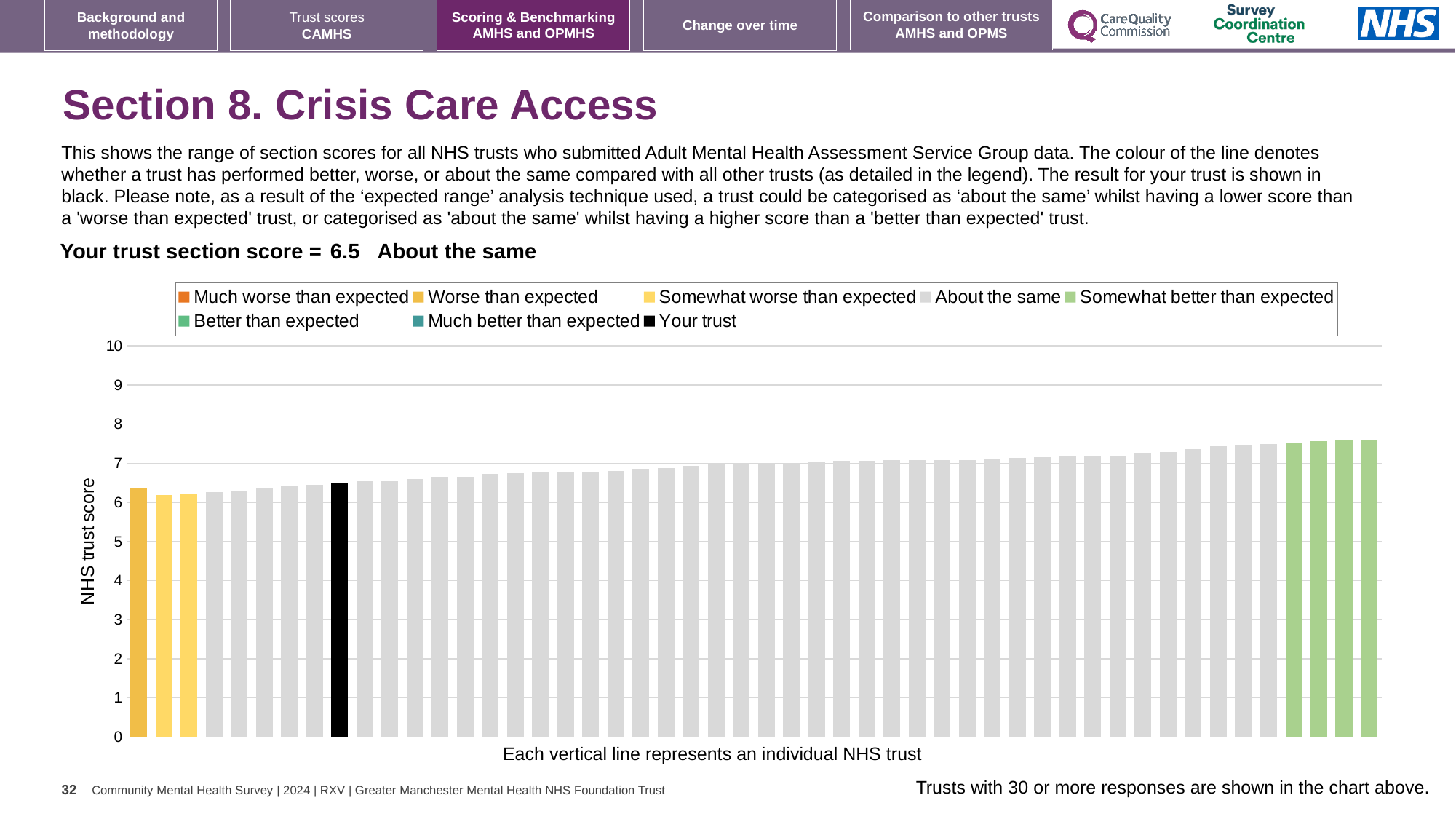
Is the value for the tallest bar in the chart greater or less than 7? greater Is the value for the tallest bar in the chart greater or less than 8? less Is the value for the shortest bar in the chart greater or less than 5? greater What is the label on the vertical axis of the chart? NHS trust score How many bars are coloured green (somewhat better than expected)? 4 Do the bar values rise or fall from left to right along the x axis? rise What kind of chart is shown on the slide? bar chart How many entries does the chart legend list? 8 Which category is your trust placed in for this section? About the same What is the section score for your trust? 6.5 What is the label below the horizontal axis of the chart? Each vertical line represents an individual NHS trust